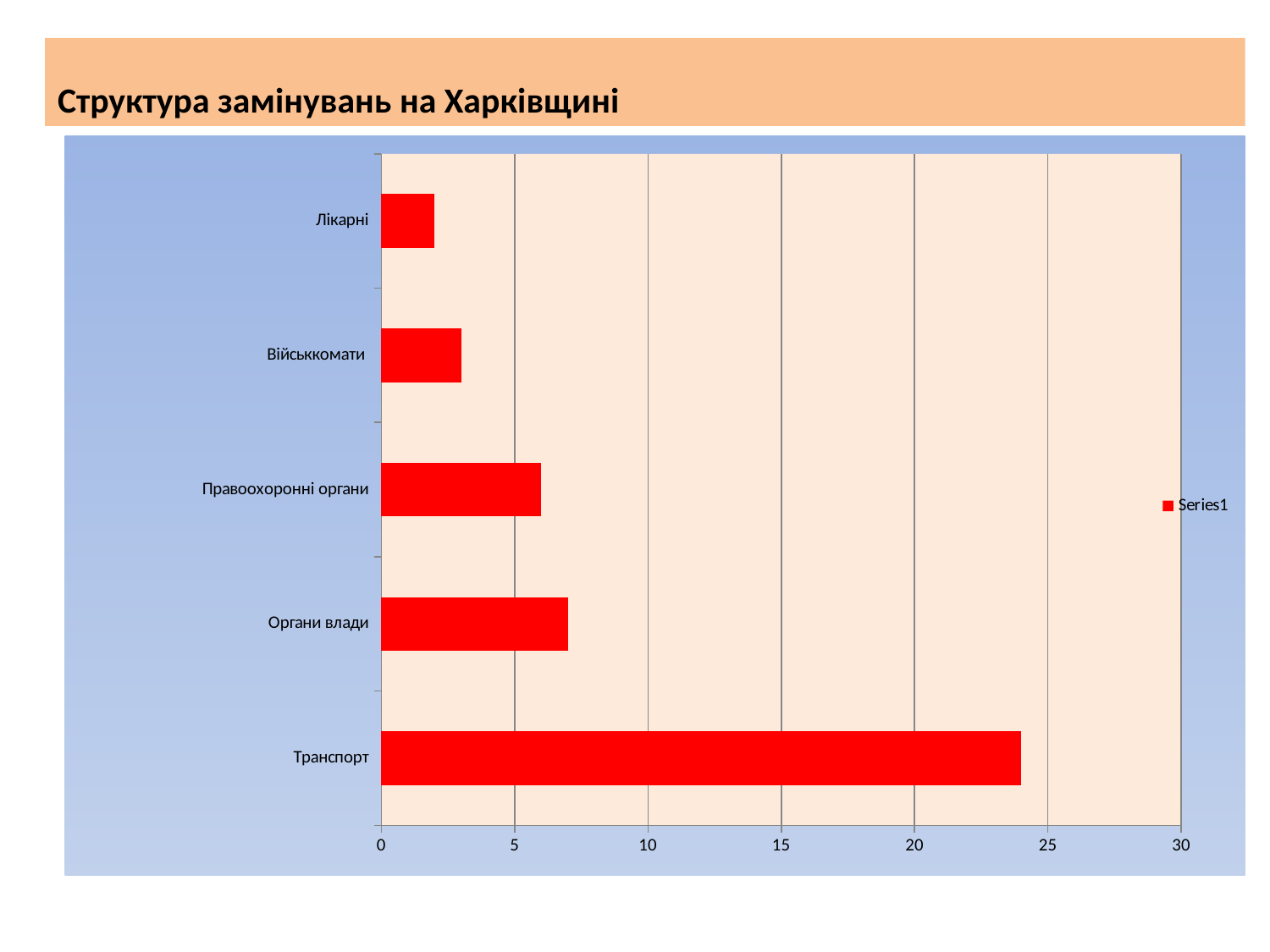
What kind of chart is shown on the slide? bar chart Is the value for Органи влади greater or less than 5? greater Is the value for Військкомати greater or less than 5? less How many series does the legend list? 1 Which category has the highest value? Транспорт Is the value for Лікарні greater or less than 5? less Which category has the lowest value? Лікарні Which is larger, the value for Правоохоронні органи or the value for Військкомати? Правоохоронні органи What is the title of the slide? Структура замінувань на Харківщині What is the name of the series shown in the legend? Series1 How many categories are shown in the chart? 5